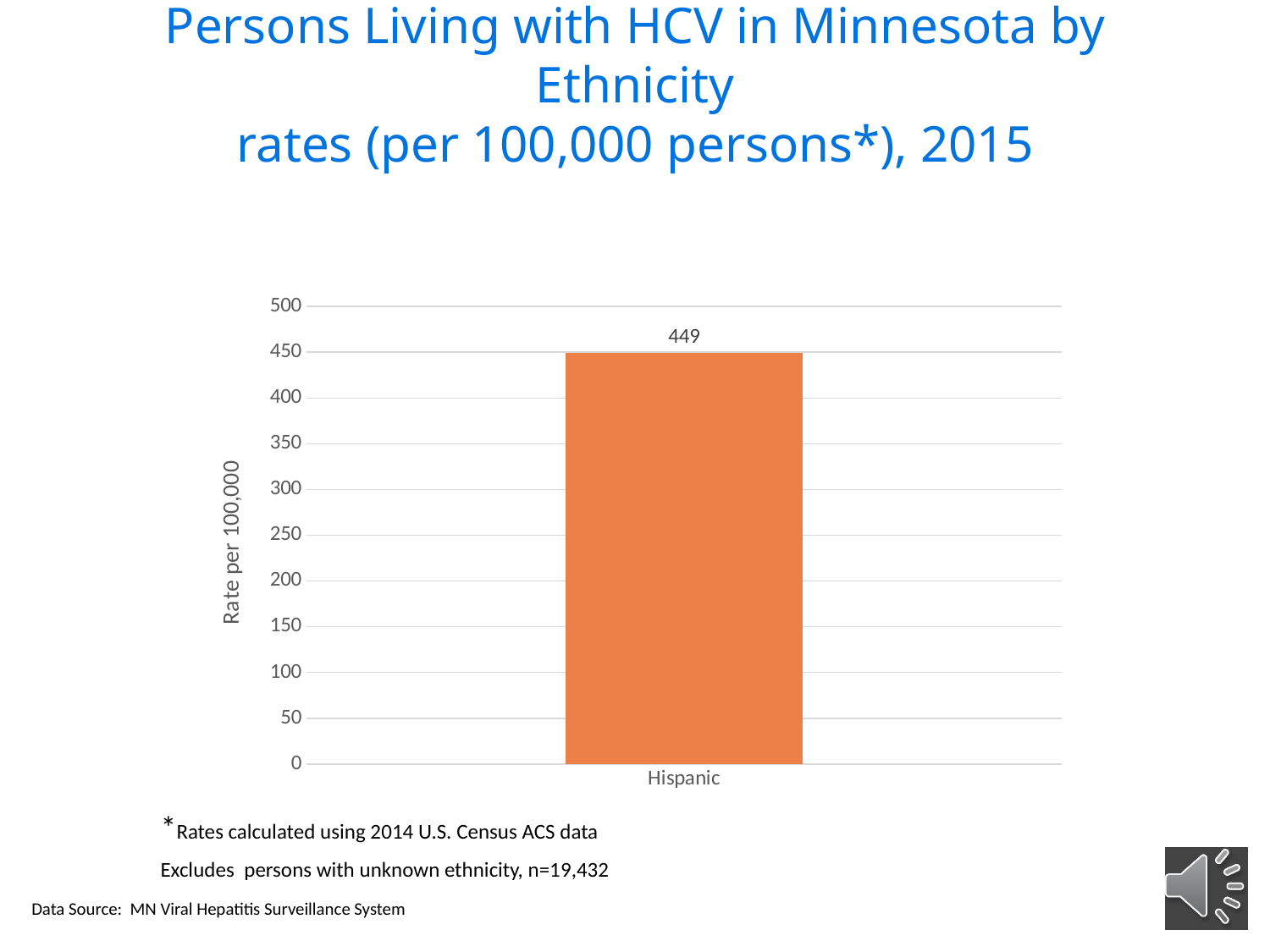
How many categories are plotted on the chart? 1 Is the value for Hispanic greater or less than 400? greater Is the value for Hispanic greater or less than 500? less What is the label on the vertical axis of the chart? Rate per 100,000 Which ethnicity category is shown on the x axis of the chart? Hispanic What is the rate per 100,000 for Hispanic persons living with HCV in Minnesota in 2015? 449 What kind of chart is shown on the slide? bar chart What is the maximum value shown on the vertical axis? 500